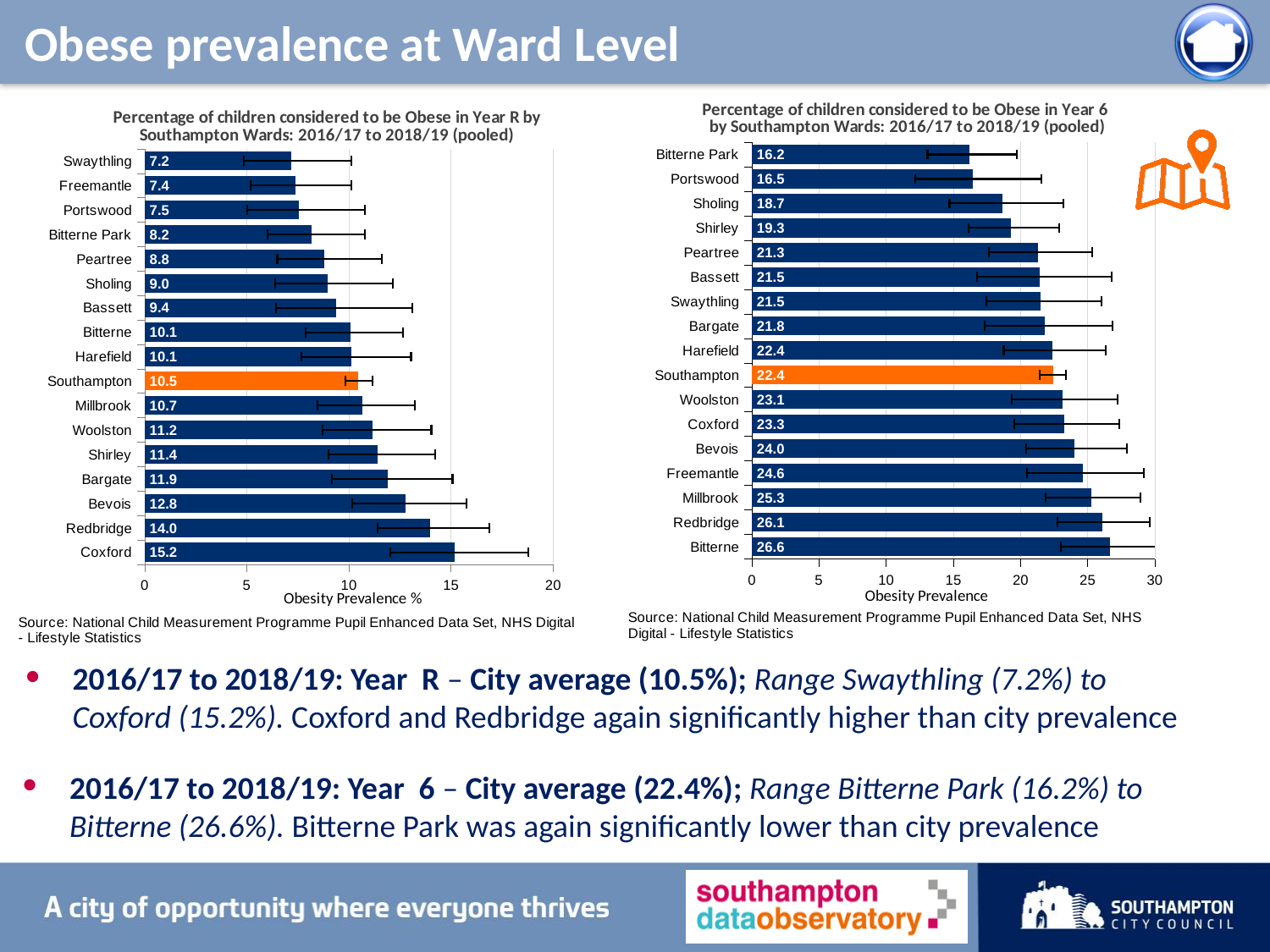
In the Year R chart on the left, what is the obesity prevalence for Coxford? 15.2 In the Year R chart on the left, which is larger, the value for Redbridge or the value for Bevois? Redbridge In the Year 6 chart on the right, what is the difference between the values for Bitterne and Bitterne Park? 10.4 What kind of chart is the Year 6 chart on the right? bar chart In the Year 6 chart on the right, what is the obesity prevalence for Bitterne Park? 16.2 In the Year R chart on the left, which ward has the lowest obesity prevalence? Swaythling How many bars are plotted in the Year R chart on the left? 17 In the Year 6 chart on the right, which ward has the highest obesity prevalence? Bitterne In the Year 6 chart on the right, what is the value for Southampton? 22.4 In the Year R chart on the left, what is the difference between the values for Coxford and Swaythling? 8.0 In the Year R chart on the left, which bar is highlighted in orange? Southampton In the Year 6 chart on the right, is the value for Sholing greater or less than 20? less